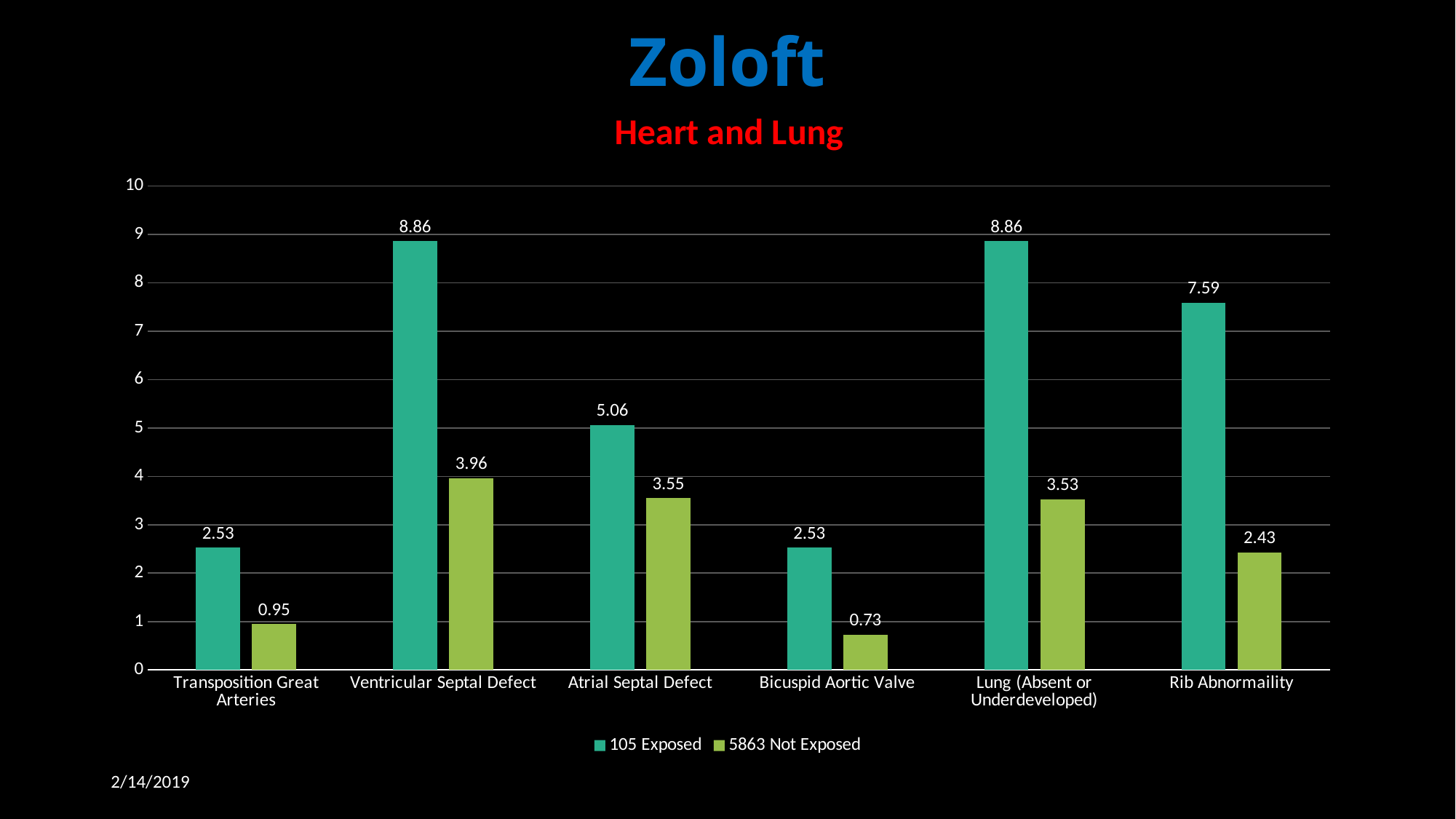
Which category has the highest value for 5863 Not Exposed? Ventricular Septal Defect How many series does the legend list? 2 How many categories are shown on the x axis? 6 What is the value for 5863 Not Exposed for Rib Abnormaility? 2.43 What is the difference between the 105 Exposed and 5863 Not Exposed values for Ventricular Septal Defect? 4.90 Which is larger for Rib Abnormaility: the 105 Exposed value or the 5863 Not Exposed value? 105 Exposed What kind of chart is shown on the slide? Bar chart What is the difference between the 105 Exposed and 5863 Not Exposed values for Transposition Great Arteries? 1.58 Is the 105 Exposed value for Lung (Absent or Underdeveloped) greater or less than 8? greater Which category has the lowest value for 5863 Not Exposed? Bicuspid Aortic Valve What is the value for 5863 Not Exposed for Bicuspid Aortic Valve? 0.73 What is the value for 105 Exposed for Atrial Septal Defect? 5.06